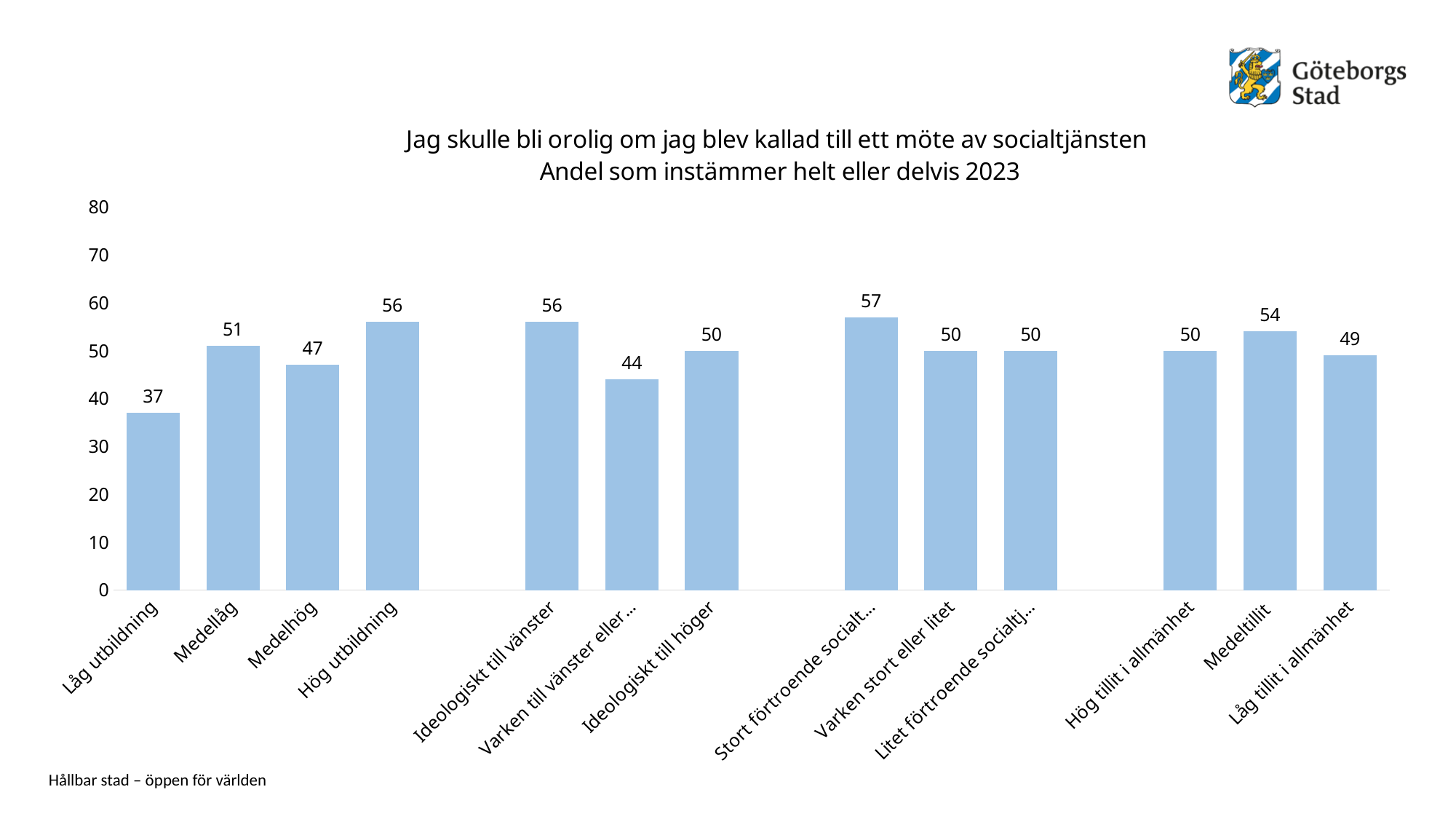
What is the value for Medeltillit? 54 What kind of chart is shown on the slide? bar chart Which category has the lowest value? Låg utbildning What is the value for Hög utbildning? 56 How many bars are plotted in the chart? 13 What is the difference between the values for Hög utbildning and Låg utbildning? 19 Which is larger, the value for Ideologiskt till vänster or the value for Ideologiskt till höger? Ideologiskt till vänster What is the value for Ideologiskt till höger? 50 What is the value for Låg tillit i allmänhet? 49 What is the value for Låg utbildning? 37 What is the difference between the values for Medellåg and Medelhög? 4 What is the first line of the chart title? Jag skulle bli orolig om jag blev kallad till ett möte av socialtjänsten